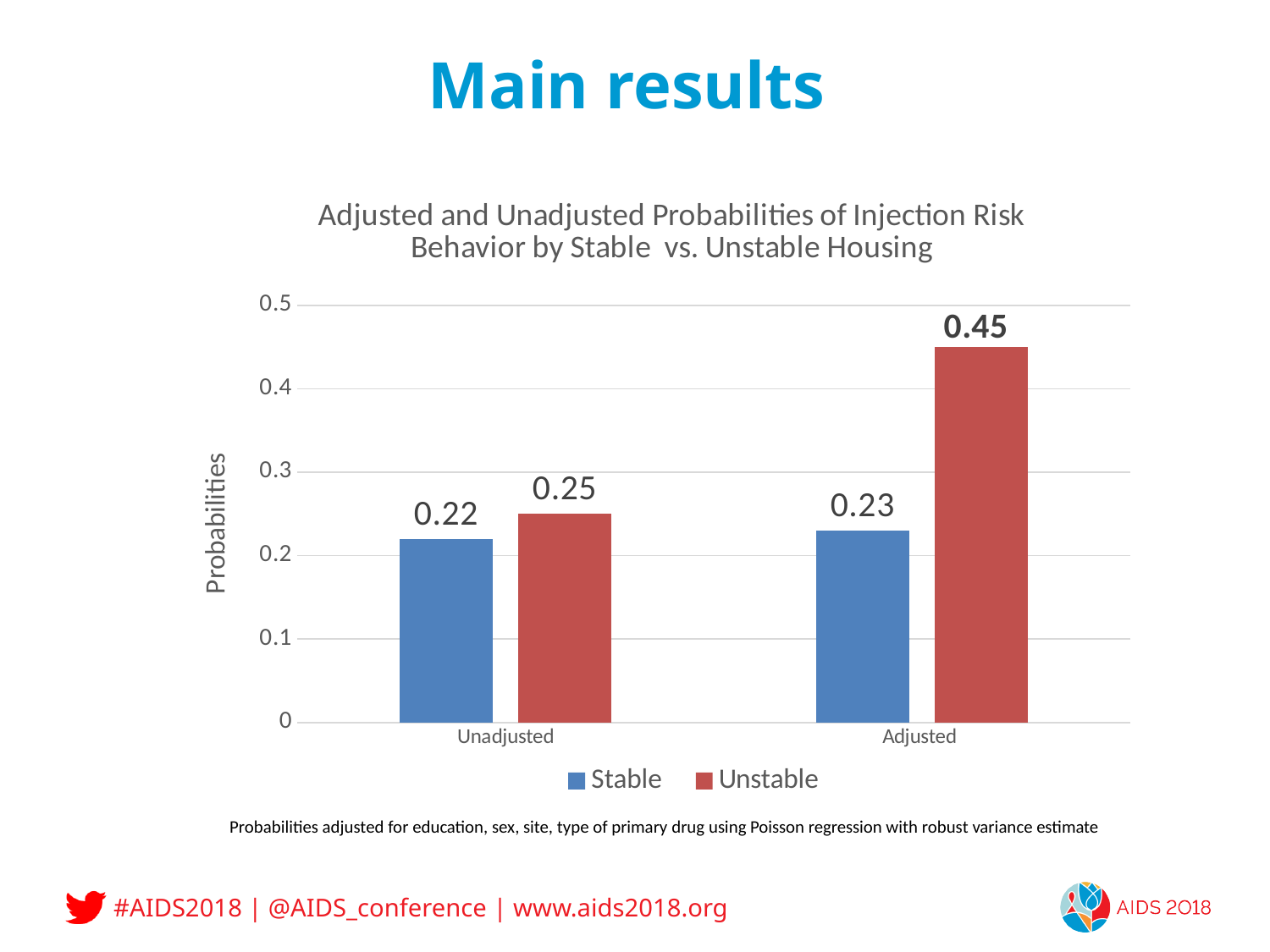
What is the Unstable value for the Unadjusted category? 0.25 How many series does the legend list? 2 What is the difference between the Unstable and Stable values in the Adjusted category? 0.22 What is the Stable value for the Unadjusted category? 0.22 What type of chart is shown on the slide? Bar chart Which bar has the lowest value in the chart? Stable, Unadjusted What is the difference between the Unstable and Stable values in the Unadjusted category? 0.03 How many categories are shown on the x axis? 2 What is the Stable value for the Adjusted category? 0.23 Which is larger: the Unstable value for Adjusted or the Unstable value for Unadjusted? Adjusted Which bar has the highest value in the chart? Unstable, Adjusted What is the Unstable value for the Adjusted category? 0.45